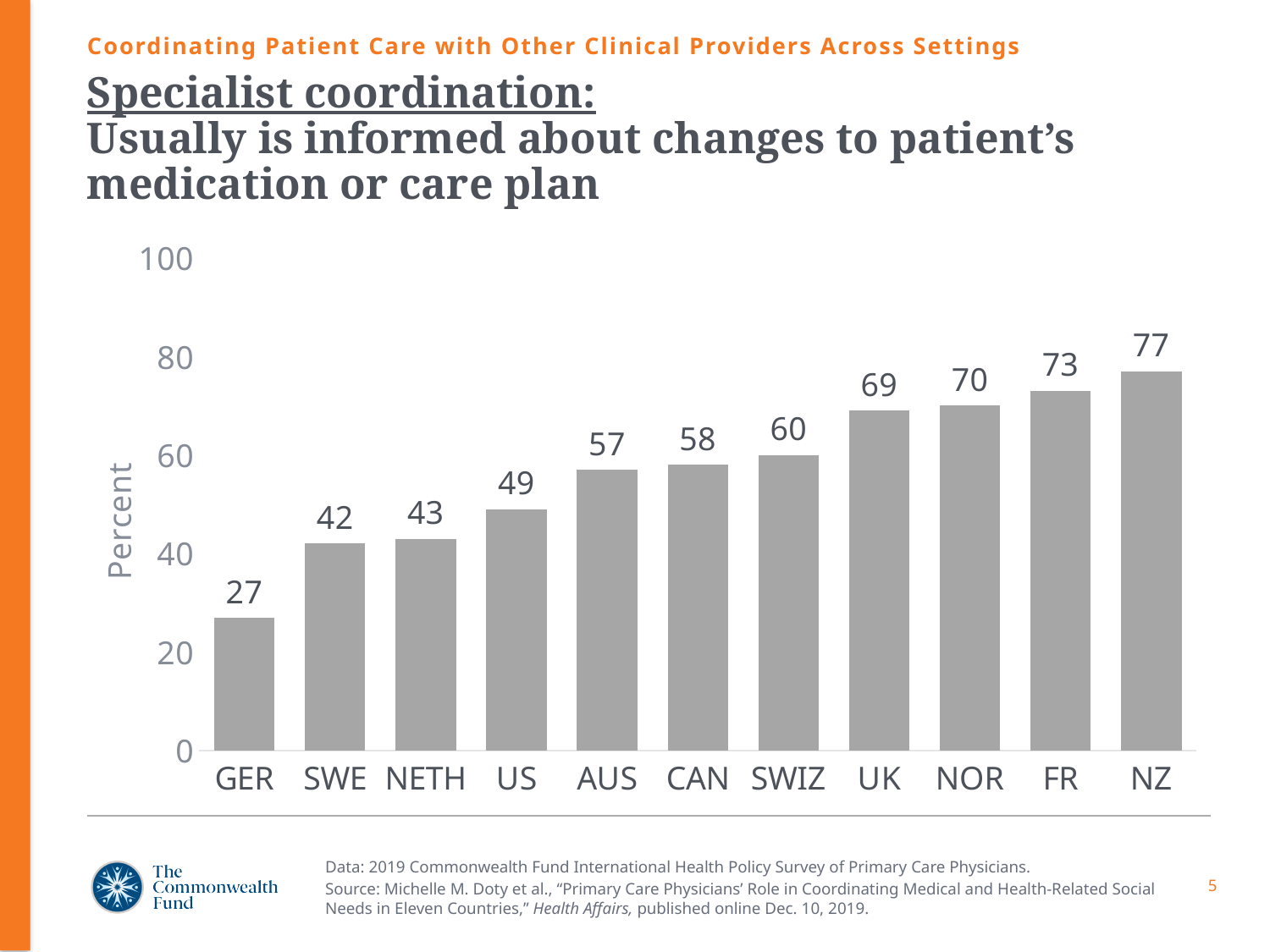
What is the value for GER? 27 Which is larger, the value for AUS or the value for NETH? AUS Which country has the highest value? NZ Which country has the lowest value? GER Do the values rise or fall from left to right along the x axis? rise What is the difference between the values for US and SWE? 7 What is the value for SWIZ? 60 What is the difference between the values for NZ and GER? 50 What is the value for NOR? 70 What kind of chart is shown on the slide? bar chart How many countries are shown in the chart? 11 Is the value for UK greater or less than 60? greater